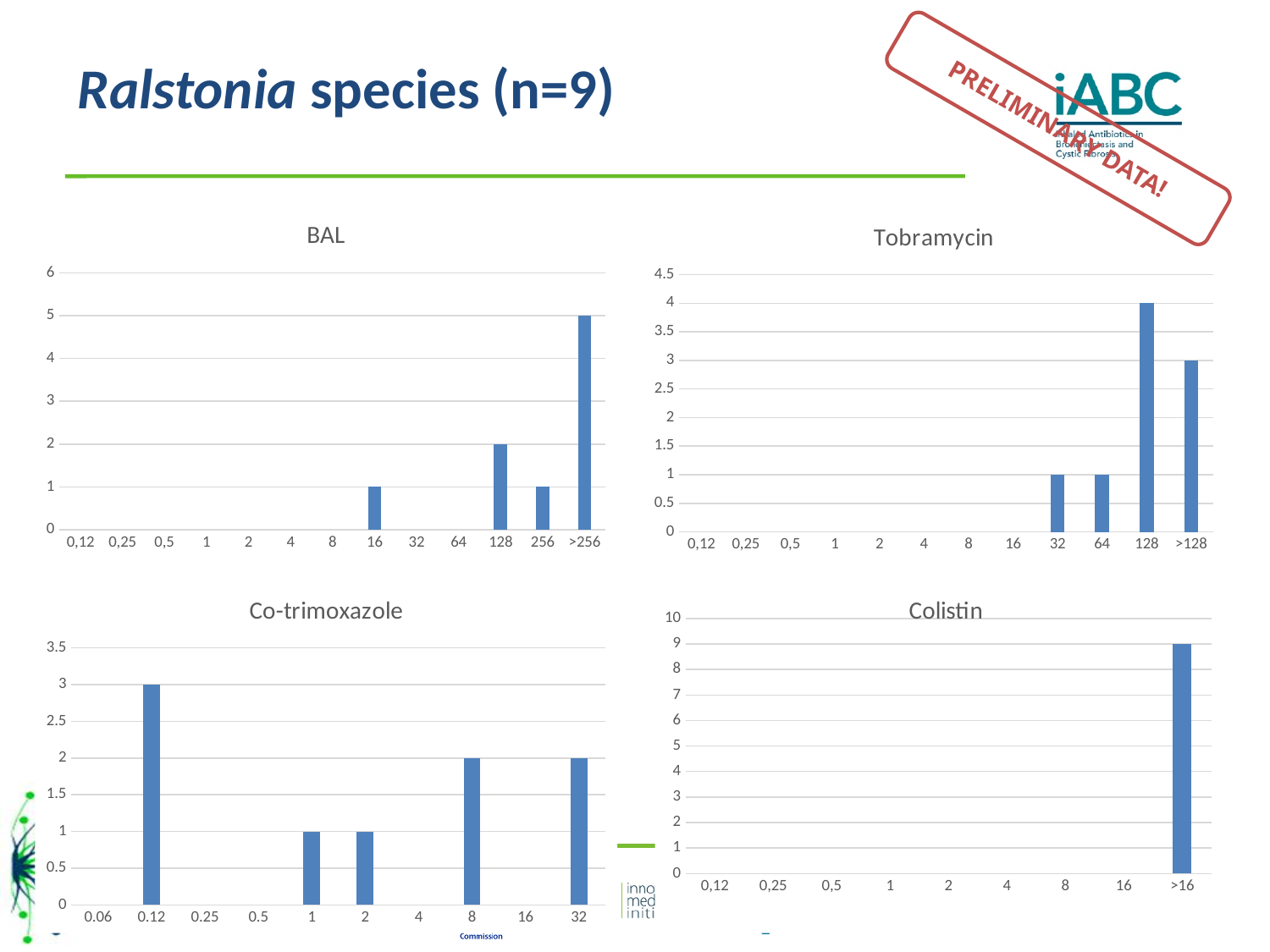
How many categories are shown on the x axis of the Colistin chart? 9 In the Tobramycin chart, what is the difference between the values for 128 and >128? 1 In the BAL chart, what is the value for the 128 category? 2 In the BAL chart, which category has the highest value? >256 What type of chart is the Tobramycin chart? Bar chart In the BAL chart, what is the value for the >256 category? 5 In the Tobramycin chart, which category has the highest value? 128 In the Colistin chart, what is the value for the >16 category? 9 In the Tobramycin chart, what is the value for the 128 category? 4 How many categories are shown on the x axis of the Co-trimoxazole chart? 10 In the Co-trimoxazole chart, what is the value for the 0.12 category? 3 In the Co-trimoxazole chart, which is larger, the value for 8 or the value for 1? 8